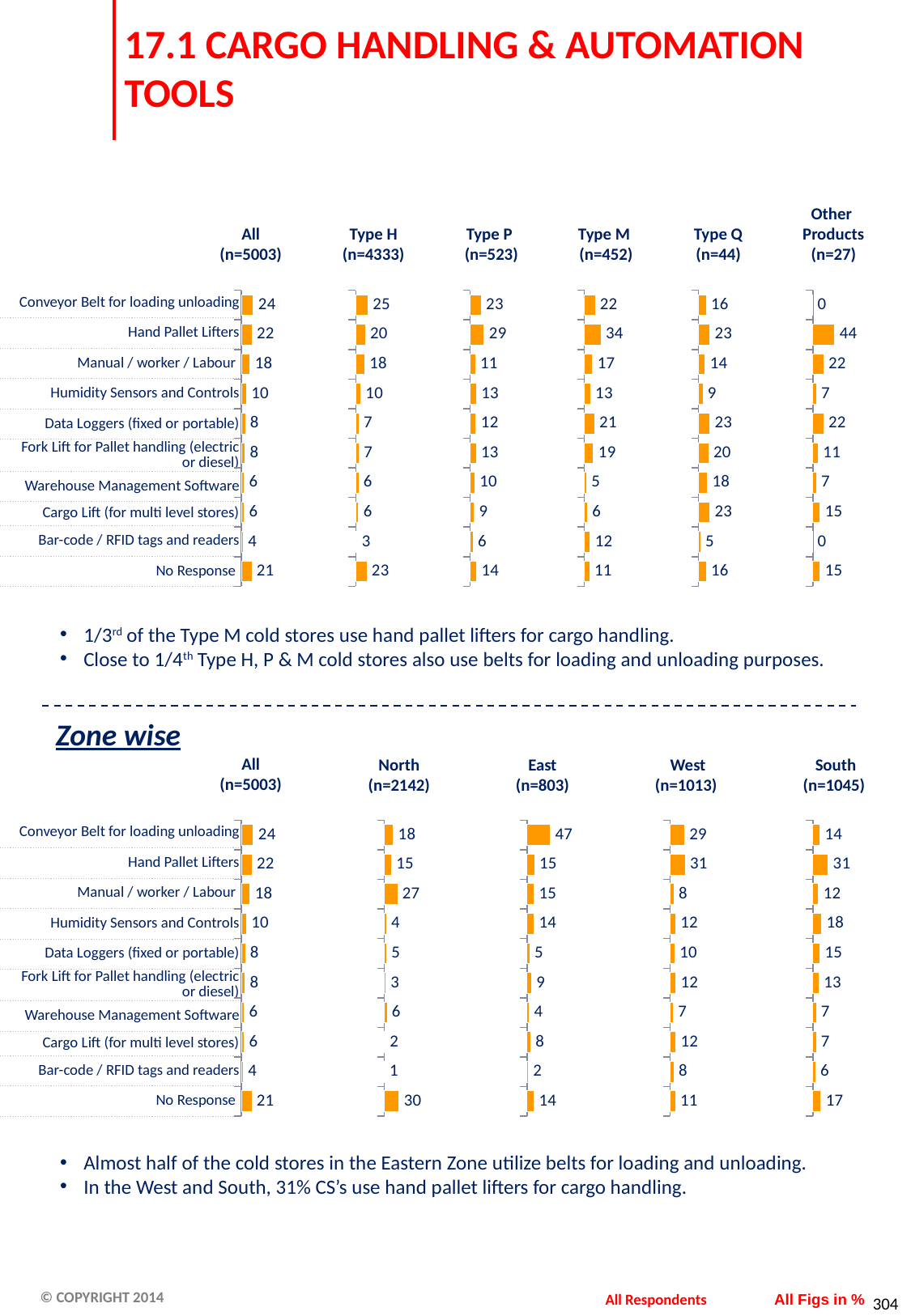
What type of chart is used on this slide? Bar chart In the top chart (by cold store type), what is the value for Conveyor Belt for loading unloading in the All (n=5003) column? 24 In the top chart (by cold store type), which category has the highest value in the Other Products (n=27) column? Hand Pallet Lifters In the Zone wise chart, which category has the highest value in the North (n=2142) column? No Response In the top chart (by cold store type), what is the value for Hand Pallet Lifters in the Type M (n=452) column? 34 In the Zone wise chart, which category has the lowest value in the West (n=1013) column? Warehouse Management Software In the top chart (by cold store type), which is larger in the Type Q (n=44) column: Cargo Lift (for multi level stores) or Warehouse Management Software? Cargo Lift (for multi level stores) How many categories are listed on the vertical axis of the Zone wise chart? 10 In the top chart (by cold store type), what is the difference between Hand Pallet Lifters and Conveyor Belt for loading unloading in the Type P (n=523) column? 6 In the Zone wise chart, what is the value for Conveyor Belt for loading unloading in the East (n=803) column? 47 In the top chart (by cold store type), which category has the lowest value in the Type H (n=4333) column? Bar-code / RFID tags and readers In the Zone wise chart, what is the difference between Hand Pallet Lifters and Manual / worker / Labour in the South (n=1045) column? 19